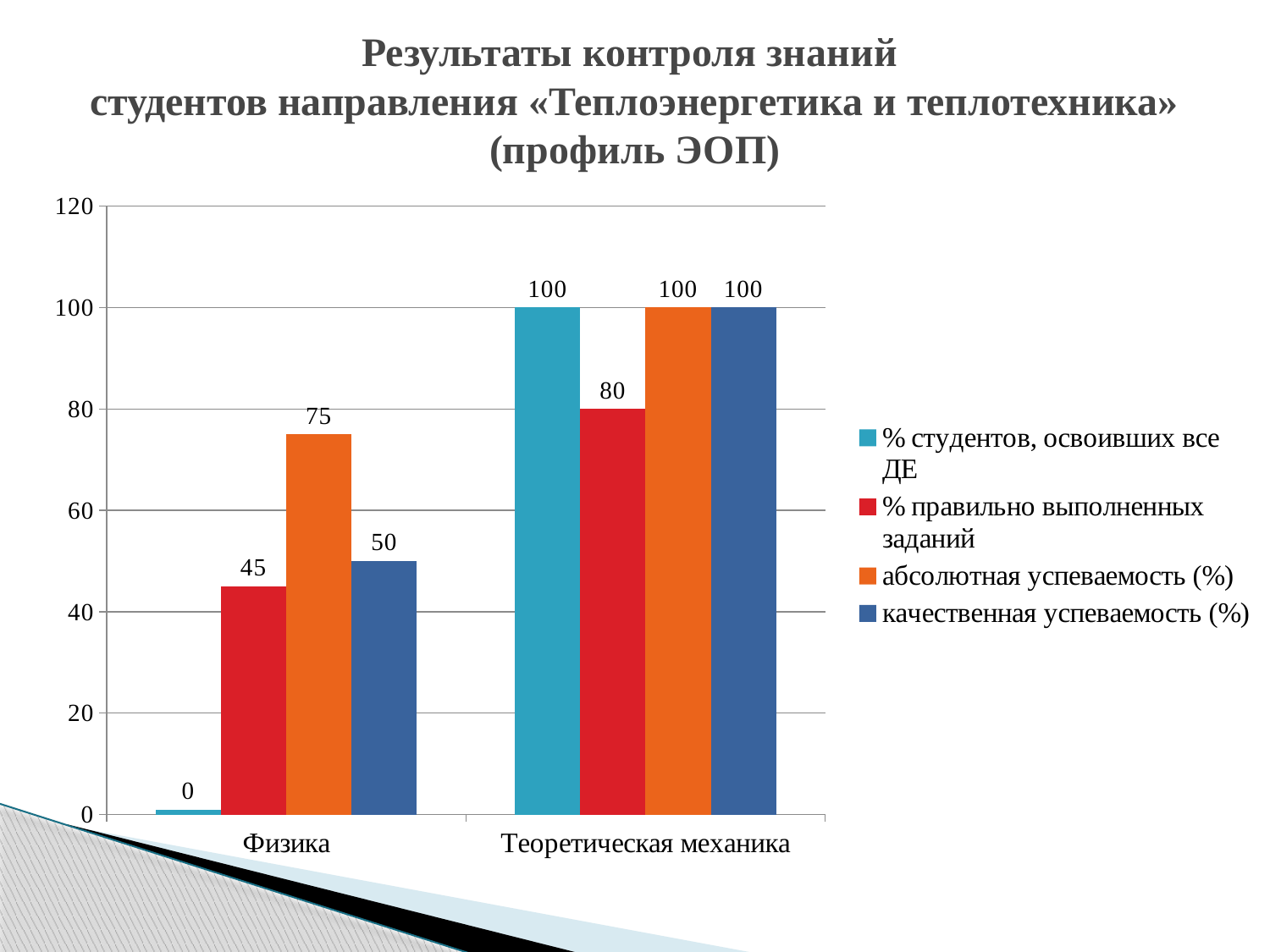
How many series does the legend list? 4 What is the value of «абсолютная успеваемость (%)» for Физика? 75 Which series has the highest value for Физика? абсолютная успеваемость (%) What is the difference between «абсолютная успеваемость (%)» for Теоретическая механика and for Физика? 25 Which series has the lowest value for Теоретическая механика? % правильно выполненных заданий What is the value of «% студентов, освоивших все ДЕ» for Физика? 0 What kind of chart is shown on the slide? Bar chart What is the value of «абсолютная успеваемость (%)» for Теоретическая механика? 100 Which is larger: «качественная успеваемость (%)» for Физика or for Теоретическая механика? Теоретическая механика What is the value of «% правильно выполненных заданий» for Физика? 45 What is the value of «качественная успеваемость (%)» for Физика? 50 What is the value of «% правильно выполненных заданий» for Теоретическая механика? 80